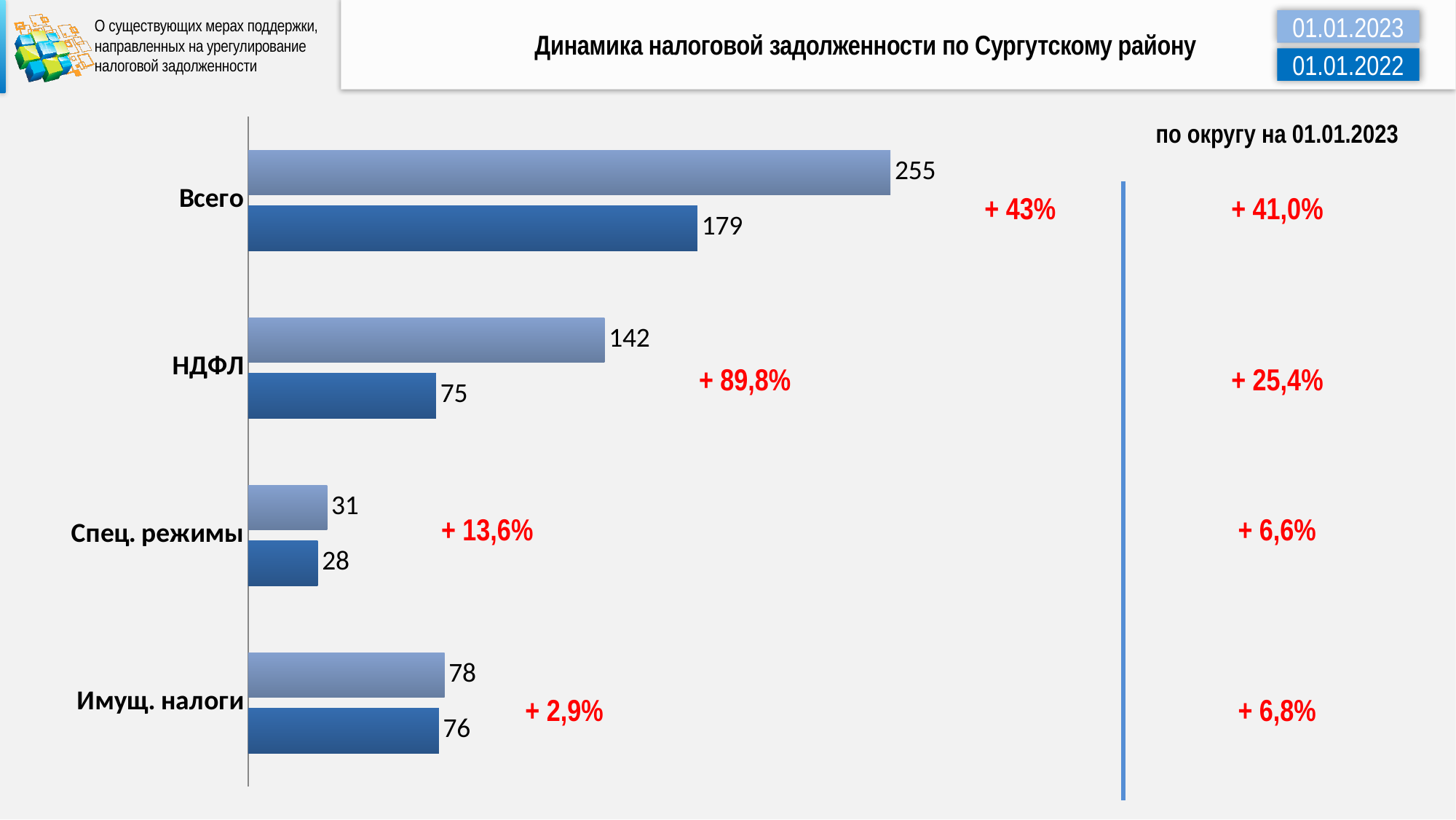
What is the difference between the 01.01.2023 and 01.01.2022 values for НДФЛ? 67 Which is larger for Имущ. налоги: the 01.01.2023 value or the 01.01.2022 value? 01.01.2023 What kind of chart is shown on the slide? Bar chart What is the value for НДФЛ on 01.01.2022? 75 Which category has the highest value on 01.01.2023? Всего What is the difference between the 01.01.2023 and 01.01.2022 values for Всего? 76 How many series does the legend list? 2 Which category has the lowest value on 01.01.2022? Спец. режимы What is the value for Имущ. налоги on 01.01.2022? 76 What is the value for Всего on 01.01.2023? 255 What is the value for Спец. режимы on 01.01.2023? 31 How many categories are shown on the chart? 4